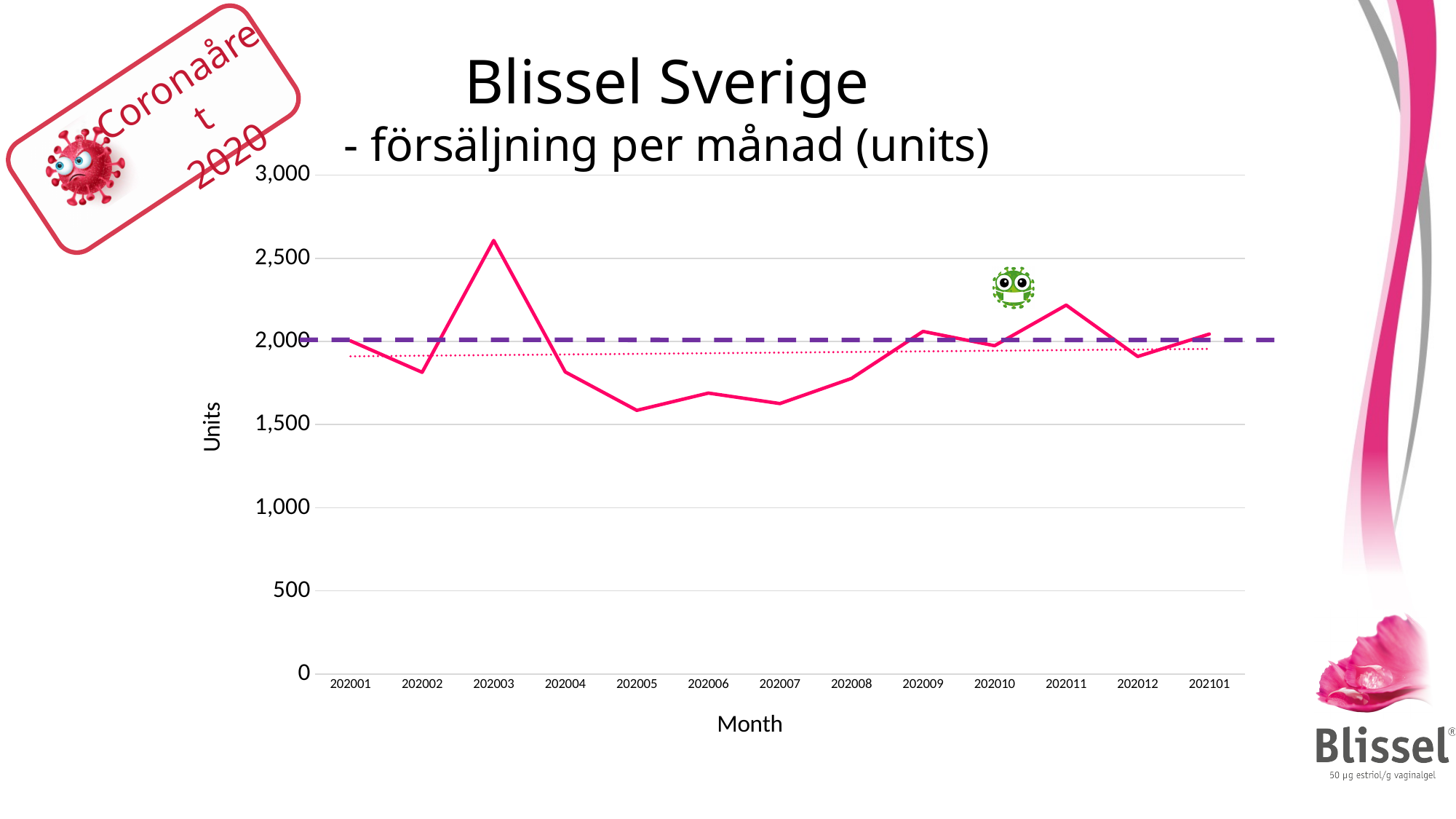
Do the values rise or fall from 202005 to 202009? rise What kind of chart is shown on the slide? line chart Which is larger, the value for 202011 or the value for 202012? 202011 How many months are plotted along the x axis? 13 Which is larger, the value for 202003 or the value for 202011? 202003 Is the value for 202011 greater or less than 2,000? greater Which month has the highest sales value? 202003 Is the value for 202006 greater or less than 1,500? greater Is the value for 202003 greater or less than 2,500? greater At what level on the y axis is the purple dashed horizontal line drawn? 2,000 What is the title of the x axis? Month